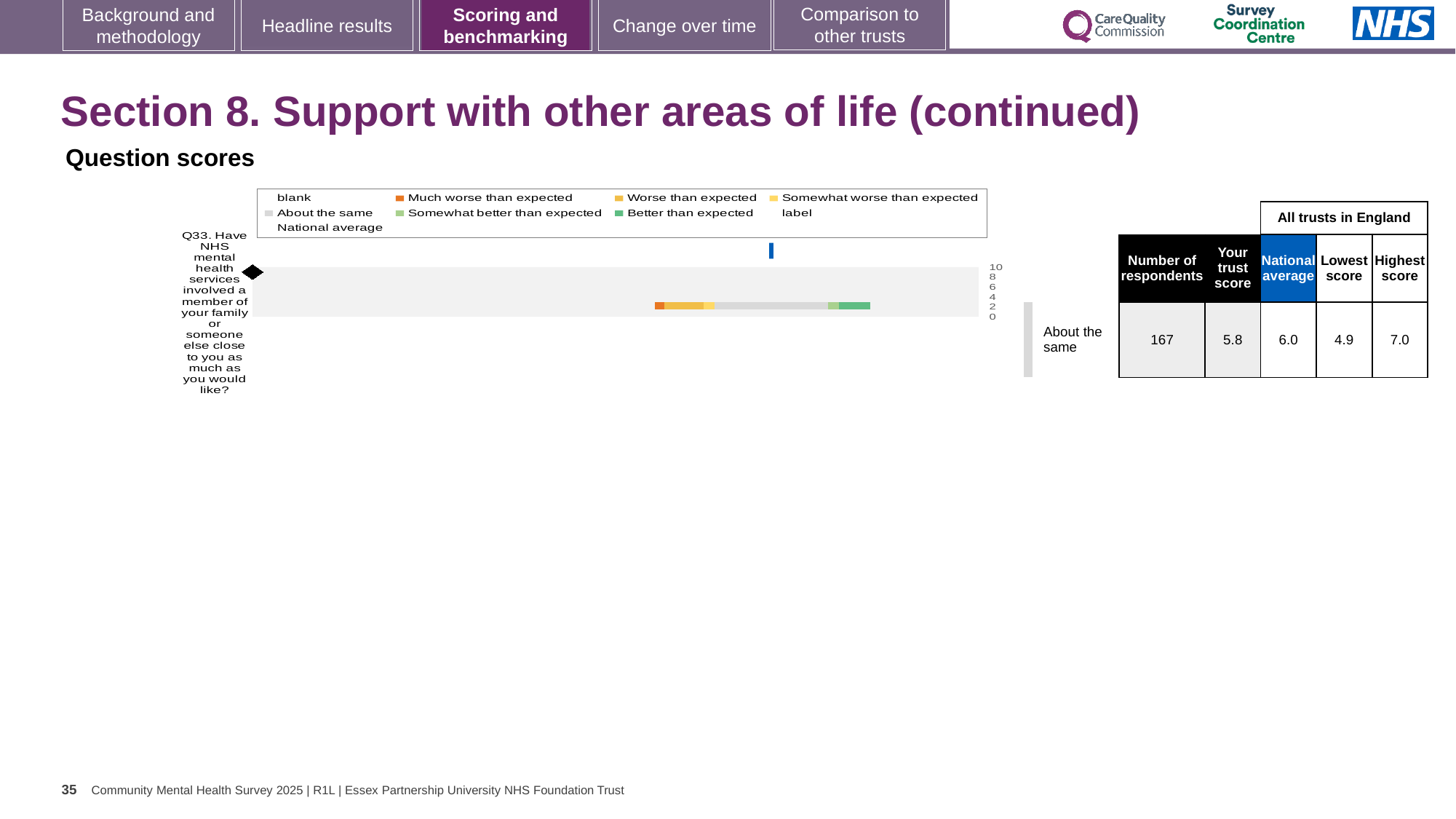
In the table beside the chart, what is the national average score for Q33? 6.0 Which is larger for Q33, the trust's score or the national average? national average In the table beside the chart, how many respondents answered Q33? 167 In the table beside the chart, what is the highest score among all trusts in England for Q33? 7.0 In the table beside the chart, what is the lowest score among all trusts in England for Q33? 4.9 How many survey questions are plotted in the chart? 1 Is the national average marker on the chart greater or less than 4? greater Which question number is plotted in the chart? Q33 Is the national average marker on the chart greater or less than 8? less In the table beside the chart, what is the trust's score for Q33? 5.8 How many entries does the chart legend list? 9 What kind of chart is used to show the Q33 question score? bar chart